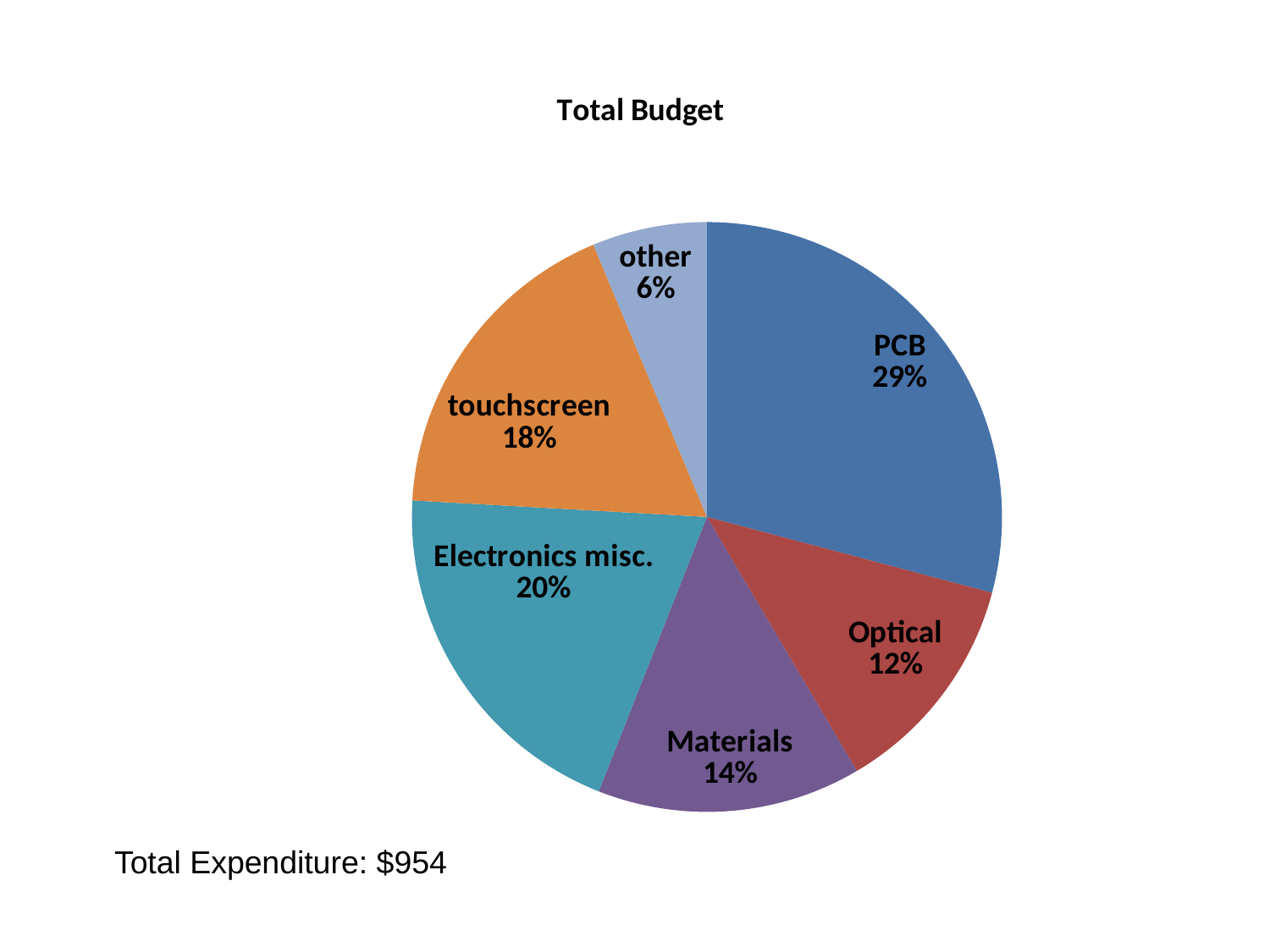
What is the difference in percentage points between PCB and Materials? 15% How many slices does the pie chart have? 6 What total expenditure is stated below the chart? $954 What is the title of the chart? Total Budget What percentage is shown for the Optical slice? 12% What share of the Total Budget pie does PCB take? 29% Which category has the largest slice of the pie? PCB What kind of chart is shown on the slide? pie chart Which category has the smallest slice of the pie? other What share of the pie is labelled Electronics misc.? 20% Which is larger, the Electronics misc. slice or the touchscreen slice? Electronics misc. What percentage is shown for the touchscreen slice? 18%